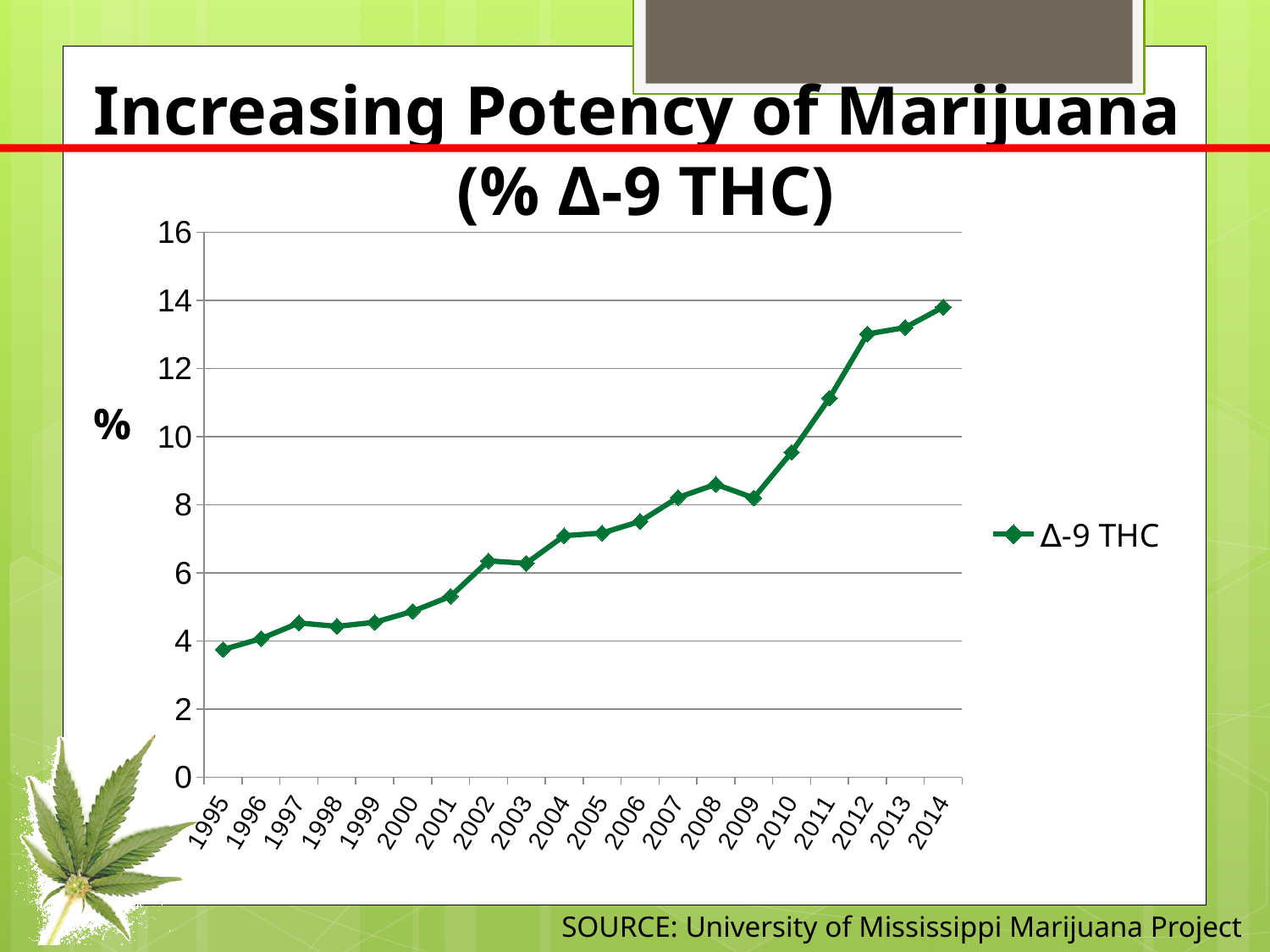
Which year has the larger Δ-9 THC value, 2012 or 2009? 2012 How many series does the legend list? 1 What kind of chart is shown on the slide? line chart Which year has the lowest Δ-9 THC value? 1995 Is the value for 2014 greater or less than 12? greater Is the value for 2010 greater or less than 10? less Is the value for 1995 greater or less than 4? less Do the Δ-9 THC values generally rise or fall from 1995 to 2014? rise How many years are plotted along the x axis? 20 What is the name of the series shown in the legend? Δ-9 THC Which year has the highest Δ-9 THC value? 2014